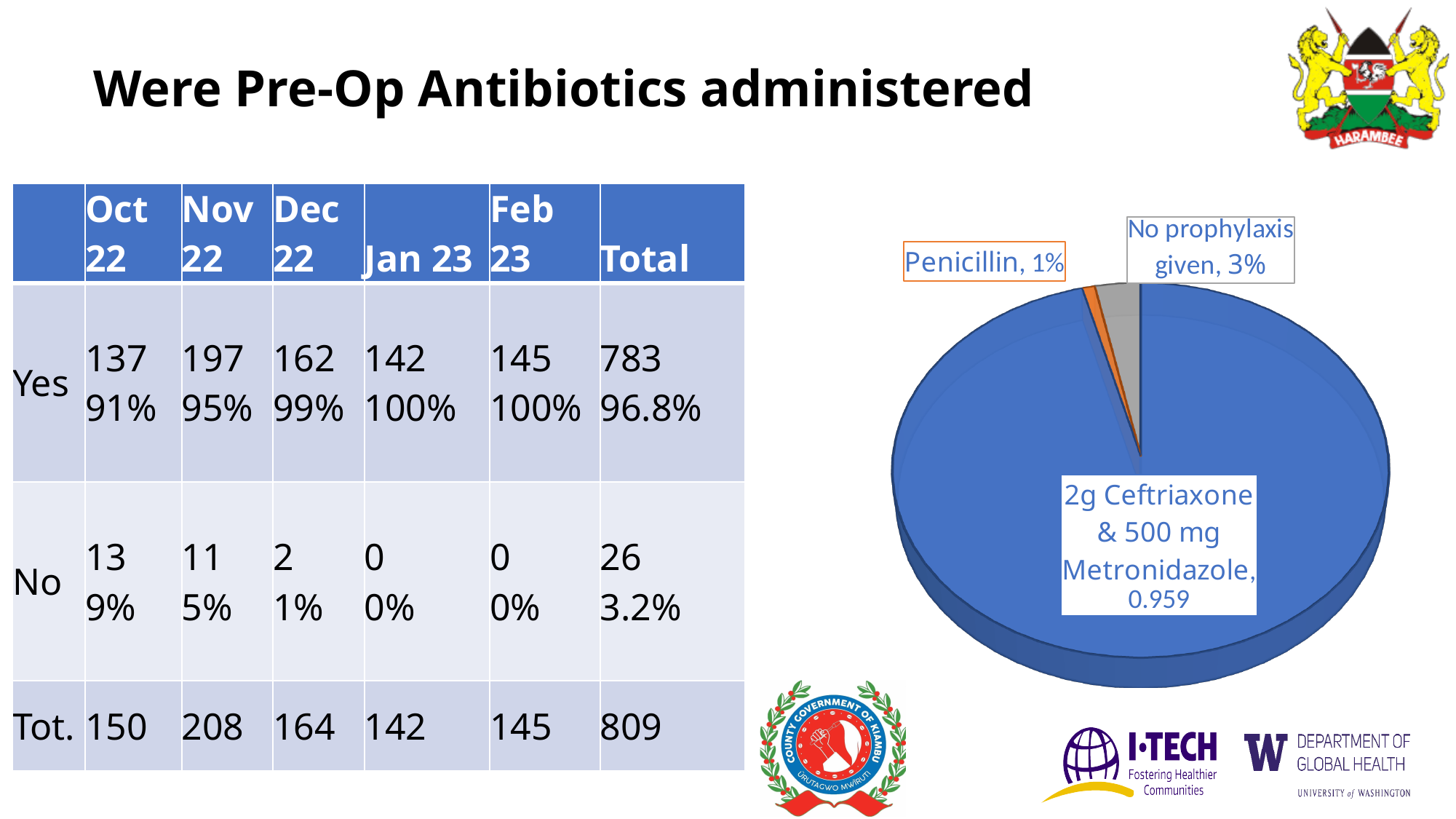
What share of the pie chart does Penicillin represent? 1% What colour is the Penicillin slice in the pie chart? orange How many slices does the pie chart have? 3 In the pie chart, what is the difference between the No prophylaxis given share and the Penicillin share? 2% In the pie chart, what value is shown for No prophylaxis given? 3% In the pie chart, what value is shown for 2g Ceftriaxone & 500 mg Metronidazole? 0.959 In the pie chart, which is larger: No prophylaxis given or Penicillin? No prophylaxis given Which slice of the pie chart is the smallest? Penicillin In the pie chart, what value is shown for Penicillin? 1% What kind of chart is shown on the right of the slide? pie chart What colour is the largest slice of the pie chart? blue Which slice of the pie chart is the largest? 2g Ceftriaxone & 500 mg Metronidazole